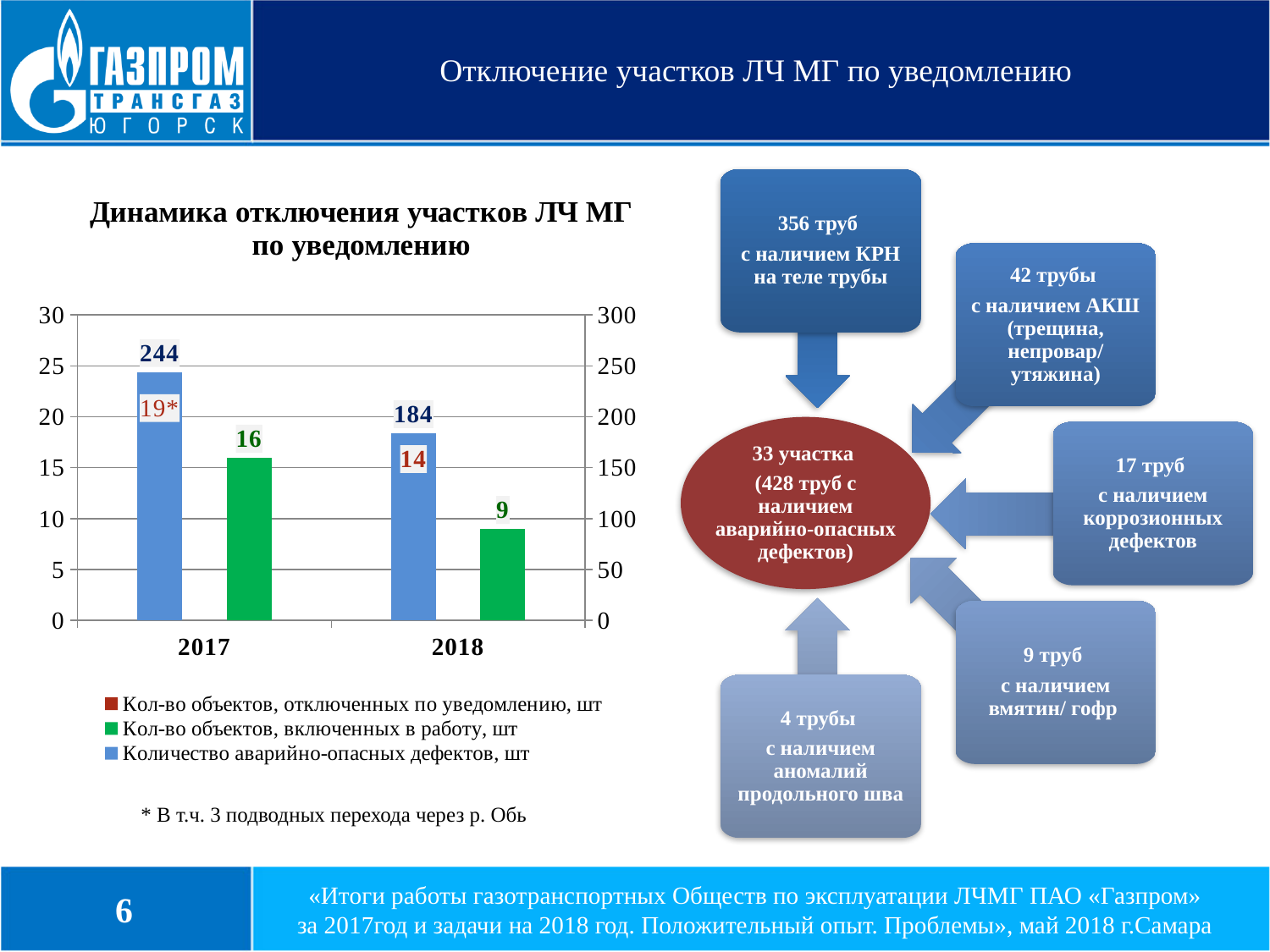
What is the value of 'Кол-во объектов, включенных в работу, шт' for 2018? 9 Which year has the higher value of 'Кол-во объектов, включенных в работу, шт'? 2017 What is the value of 'Количество аварийно-опасных дефектов, шт' for 2018? 184 How many series does the chart legend list? 3 What is the value of 'Количество аварийно-опасных дефектов, шт' for 2017? 244 What type of chart is shown on the slide? bar chart How many years (categories) are shown on the x axis of the chart? 2 Does 'Количество аварийно-опасных дефектов, шт' rise or fall from 2017 to 2018? fall What is the value of 'Кол-во объектов, отключенных по уведомлению, шт' for 2018? 14 What is the difference between 'Кол-во объектов, включенных в работу, шт' in 2017 and 2018? 7 By how much did 'Количество аварийно-опасных дефектов, шт' decrease from 2017 to 2018? 60 What is the value of 'Кол-во объектов, включенных в работу, шт' for 2017? 16